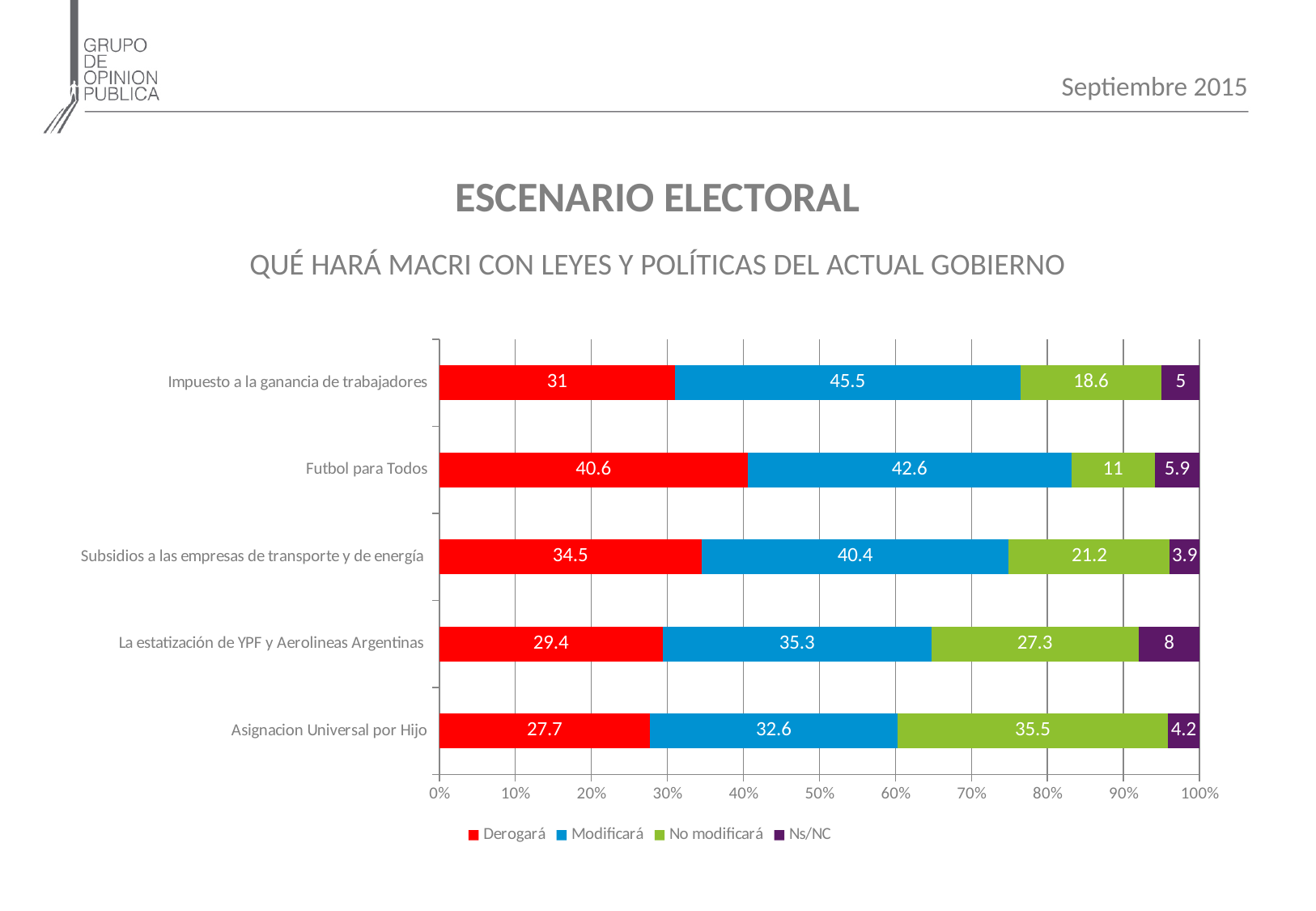
What is the Ns/NC value for Subsidios a las empresas de transporte y de energía? 3.9 What is the Modificará value for Impuesto a la ganancia de trabajadores? 45.5 How many categories are shown on the chart? 5 What kind of chart is shown on the slide? Stacked bar chart Which category has the highest No modificará value? Asignacion Universal por Hijo What is the Derogará value for Futbol para Todos? 40.6 Which is larger: the Modificará value for Futbol para Todos or for Subsidios a las empresas de transporte y de energía? Futbol para Todos What is the No modificará value for La estatización de YPF y Aerolineas Argentinas? 27.3 Which category has the lowest Derogará value? Asignacion Universal por Hijo Which category has the highest Derogará value? Futbol para Todos What is the difference between the Derogará values for Futbol para Todos and Asignacion Universal por Hijo? 12.9 How many series does the legend list? 4